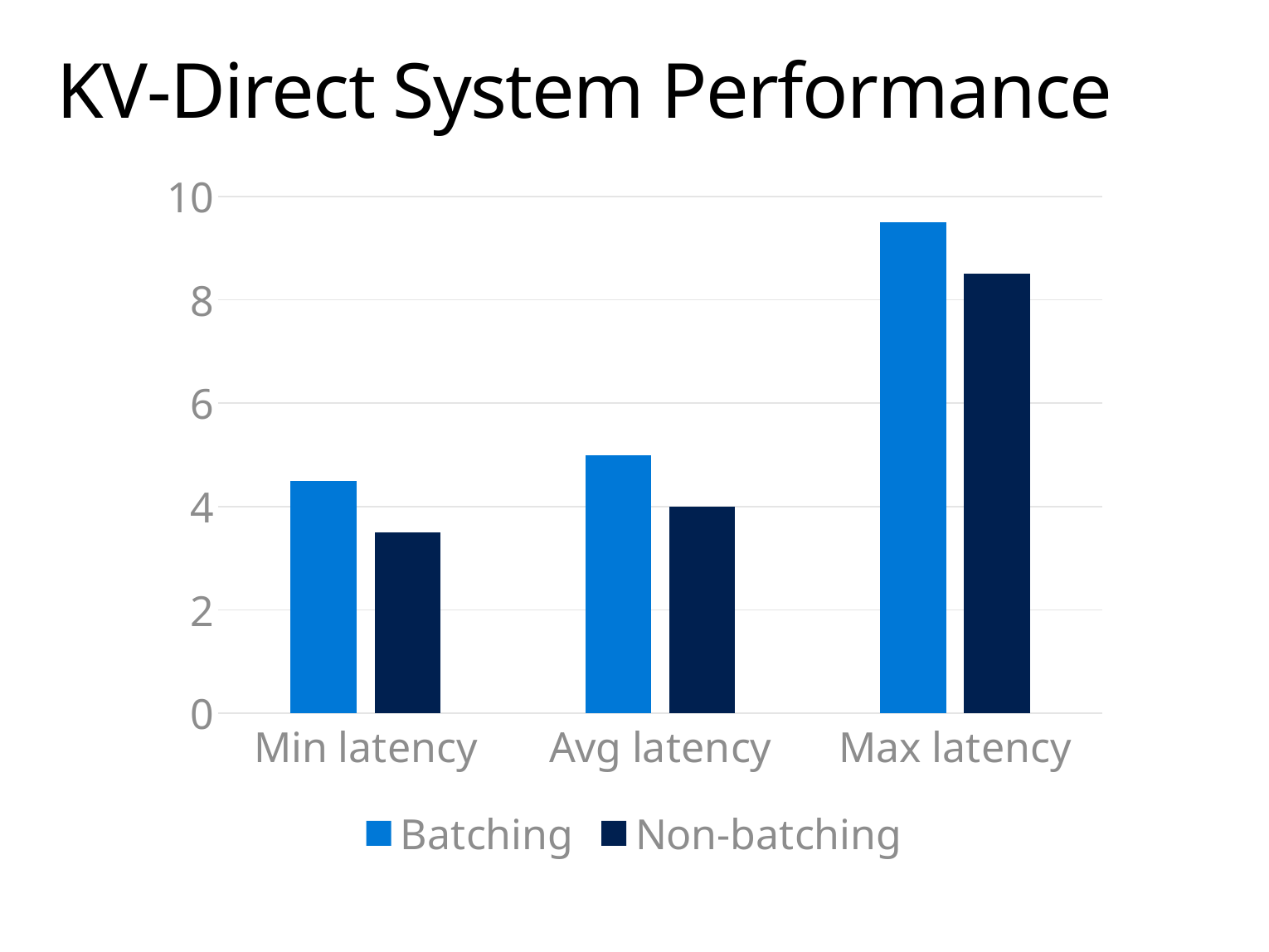
What is the title of the chart? KV-Direct System Performance Is the Non-batching value for Min latency greater or less than 4? less Is the Batching value for Min latency greater or less than 4? greater For Max latency, which series has the larger value, Batching or Non-batching? Batching Which category has the lowest Non-batching value? Min latency How many categories are shown on the x axis? 3 What kind of chart is shown on the slide? bar chart How many series does the legend list? 2 Which category has the highest Batching value? Max latency Is the Batching value for Max latency greater or less than 8? greater Which series is shown in the darker navy colour? Non-batching Do the Batching values rise or fall from Min latency to Max latency? rise